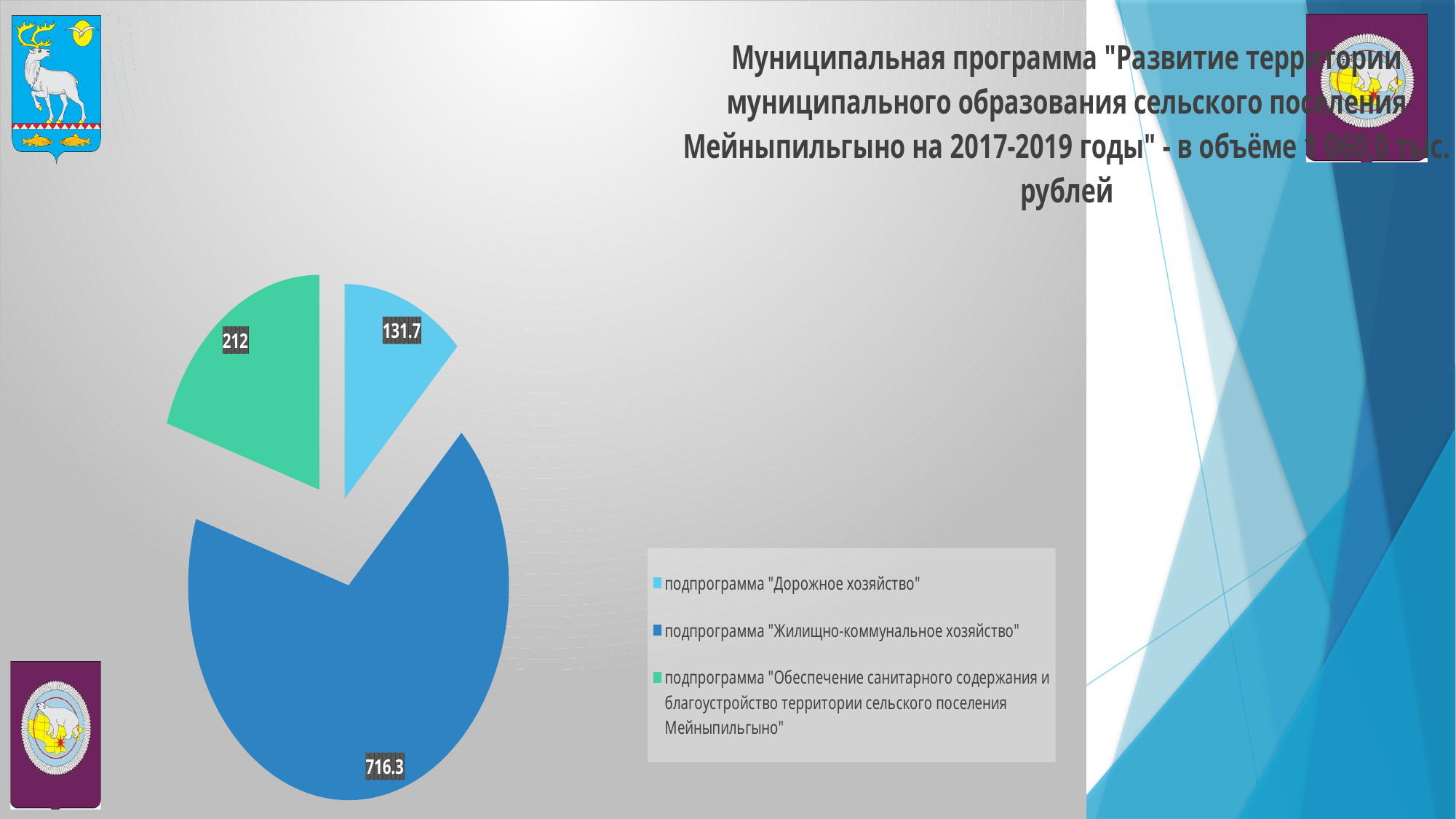
How many entries does the legend of the pie chart list? 3 Which subprogram has the smallest slice of the pie? подпрограмма "Дорожное хозяйство" What is the difference between the values for подпрограмма "Жилищно-коммунальное хозяйство" and подпрограмма "Дорожное хозяйство"? 584.6 Which is larger: the value for подпрограмма "Обеспечение санитарного содержания и благоустройство территории сельского поселения Мейныпильгыно" or the value for подпрограмма "Дорожное хозяйство"? подпрограмма "Обеспечение санитарного содержания и благоустройство территории сельского поселения Мейныпильгыно" What is the total of the three values shown on the pie chart? 1060 Which subprogram has the largest slice of the pie? подпрограмма "Жилищно-коммунальное хозяйство" What kind of chart is shown on the slide? Pie chart What colour is the slice for подпрограмма "Жилищно-коммунальное хозяйство"? Dark blue What is the value for подпрограмма "Обеспечение санитарного содержания и благоустройство территории сельского поселения Мейныпильгыно"? 212 How many slices does the pie chart have? 3 What is the value for подпрограмма "Дорожное хозяйство"? 131.7 What is the value for подпрограмма "Жилищно-коммунальное хозяйство"? 716.3